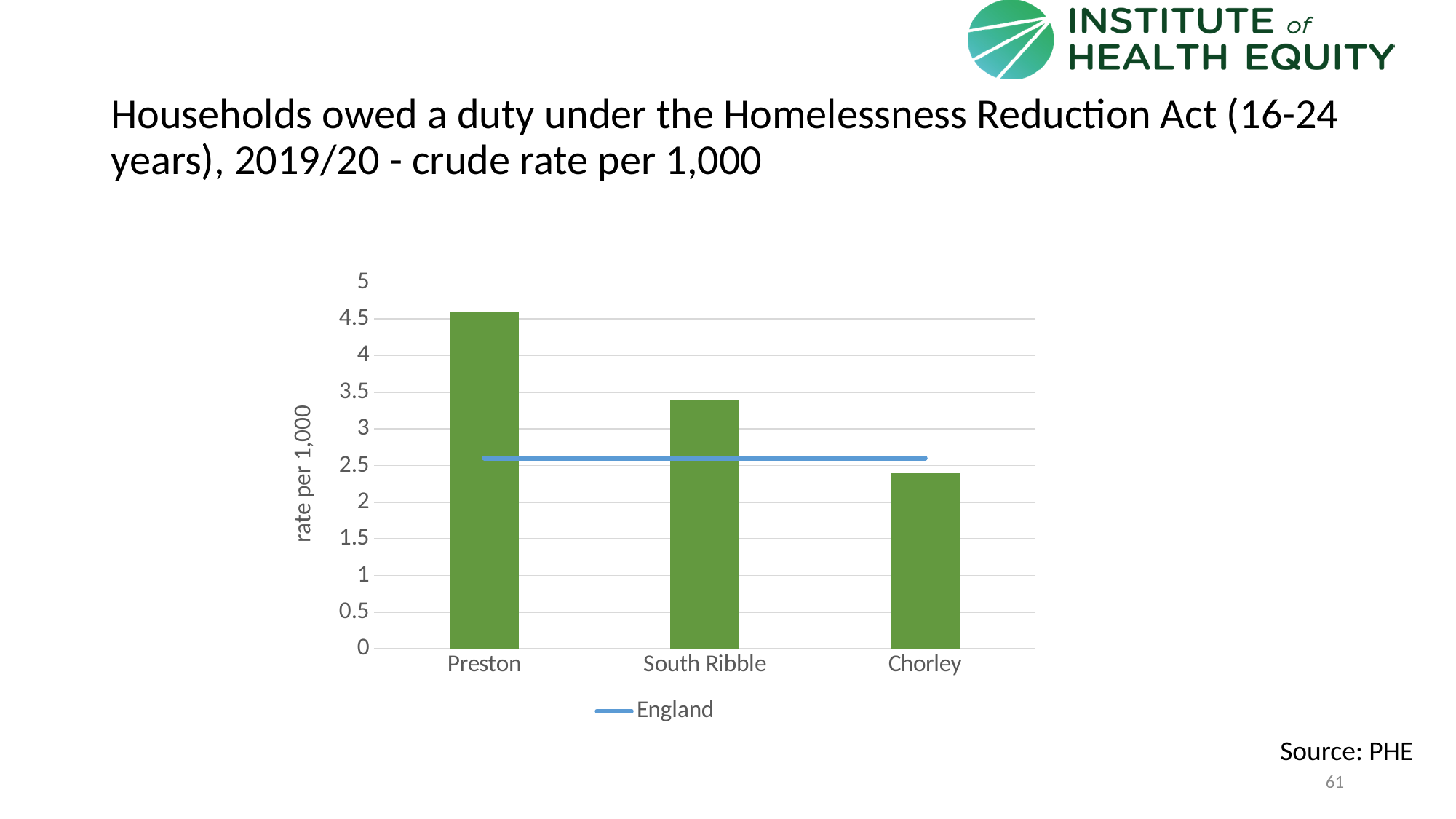
Is the value for Preston greater or less than 4? greater What type of chart is shown on the slide? bar chart Do the bar values rise or fall from Preston to Chorley along the x axis? fall How many local areas are shown as bars on the chart? 3 Is the value for Chorley greater or less than 2? greater Is the England line greater or less than 3? less What is the label on the vertical axis? rate per 1,000 Which area has the highest rate per 1,000? Preston How many entries does the legend list? 1 Which area has the lowest rate per 1,000? Chorley Which is larger, the value for South Ribble or the value for Chorley? South Ribble